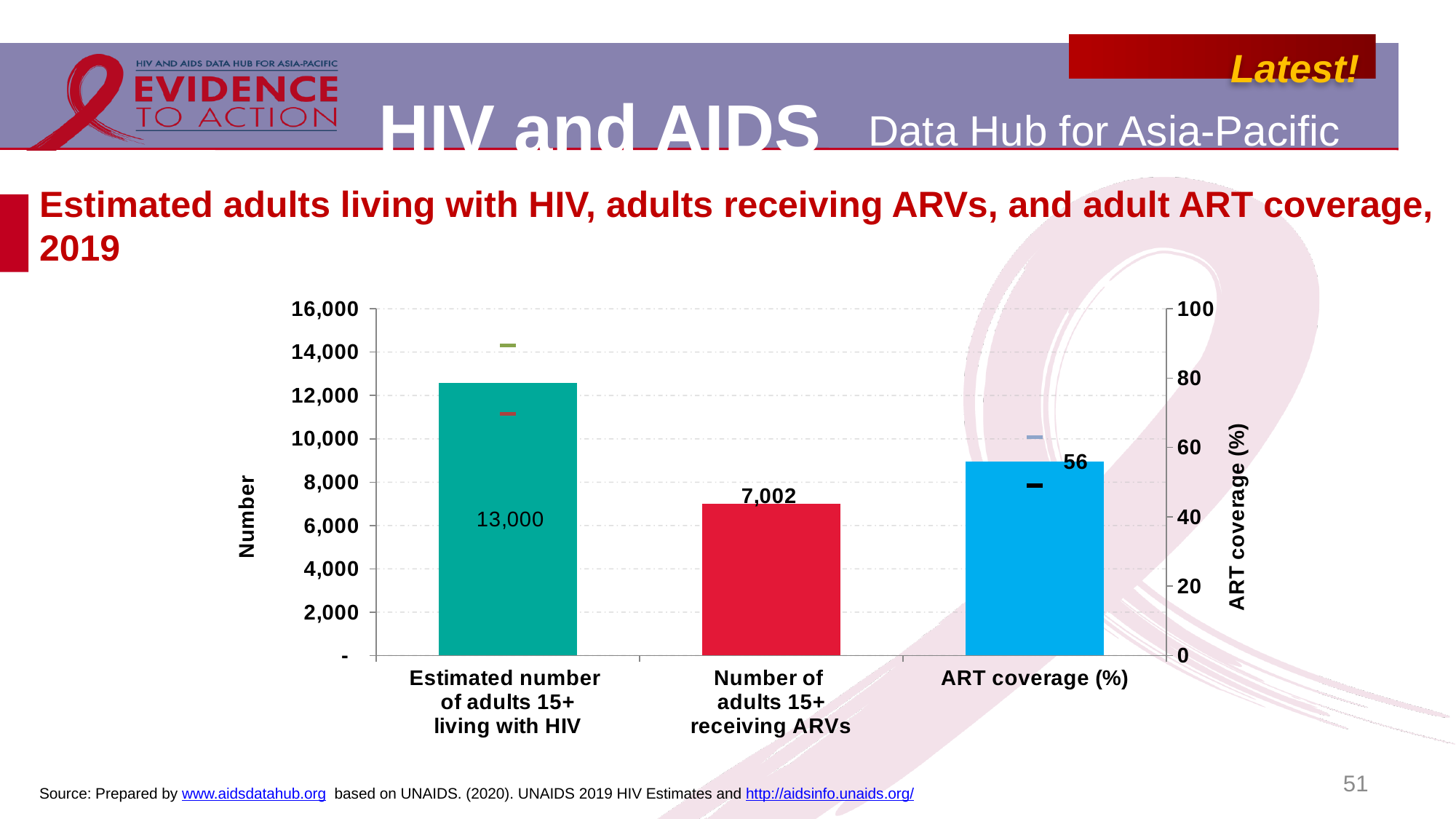
How many bars are plotted on the chart? 3 What is the ART coverage (%) value shown on the chart? 56 Is the number of adults 15+ receiving ARVs greater or less than 8,000? less What is the title of the left vertical axis of the chart? Number Is the ART coverage (%) value greater or less than 60 on the right-hand axis? less What is the number of adults 15+ receiving ARVs shown on the chart? 7,002 Which is larger: the estimated number of adults 15+ living with HIV or the number of adults 15+ receiving ARVs? Estimated number of adults 15+ living with HIV What type of chart is shown on the slide? Bar chart What is the estimated number of adults 15+ living with HIV shown on the chart? 13,000 What is the difference between the estimated number of adults 15+ living with HIV and the number of adults 15+ receiving ARVs? 5,998 What is the maximum value shown on the right-hand ART coverage (%) axis? 100 What is the title of the right vertical axis of the chart? ART coverage (%)